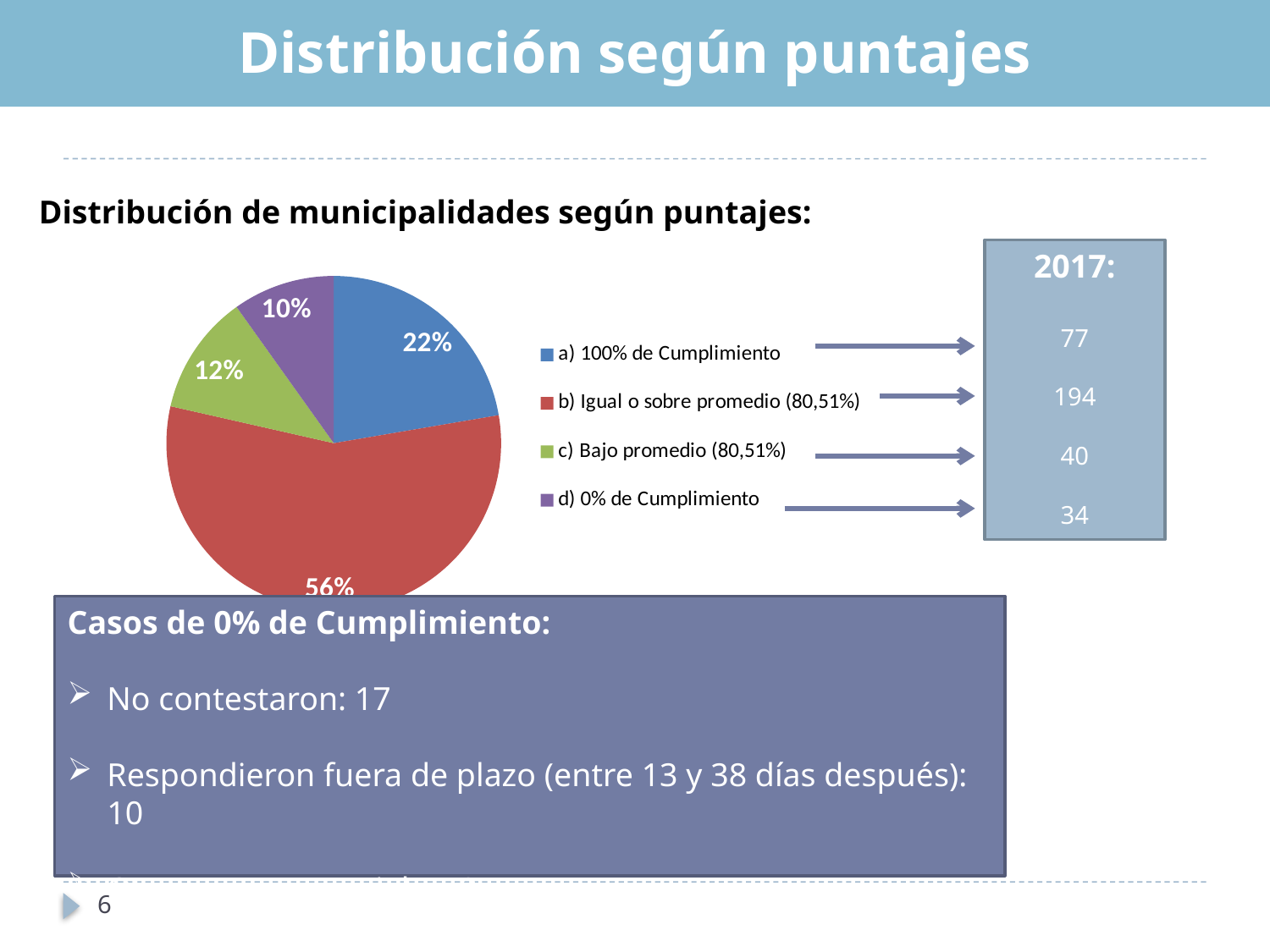
What percentage of the pie corresponds to 'b) Igual o sobre promedio (80,51%)'? 56% Which category has the smallest share of the pie? d) 0% de Cumplimiento What percentage of the pie corresponds to 'c) Bajo promedio (80,51%)'? 12% What colour is the slice for 'b) Igual o sobre promedio (80,51%)'? Red What is the difference in percentage points between 'b) Igual o sobre promedio (80,51%)' and 'a) 100% de Cumplimiento'? 34 percentage points How many categories does the pie chart have? 4 Which is larger: the share for 'c) Bajo promedio (80,51%)' or the share for 'd) 0% de Cumplimiento'? c) Bajo promedio (80,51%) What type of chart is shown on the slide? Pie chart What colour is the slice for 'a) 100% de Cumplimiento'? Blue Which category has the largest share of the pie? b) Igual o sobre promedio (80,51%) What percentage of the pie corresponds to 'd) 0% de Cumplimiento'? 10% What percentage of the pie corresponds to 'a) 100% de Cumplimiento'? 22%